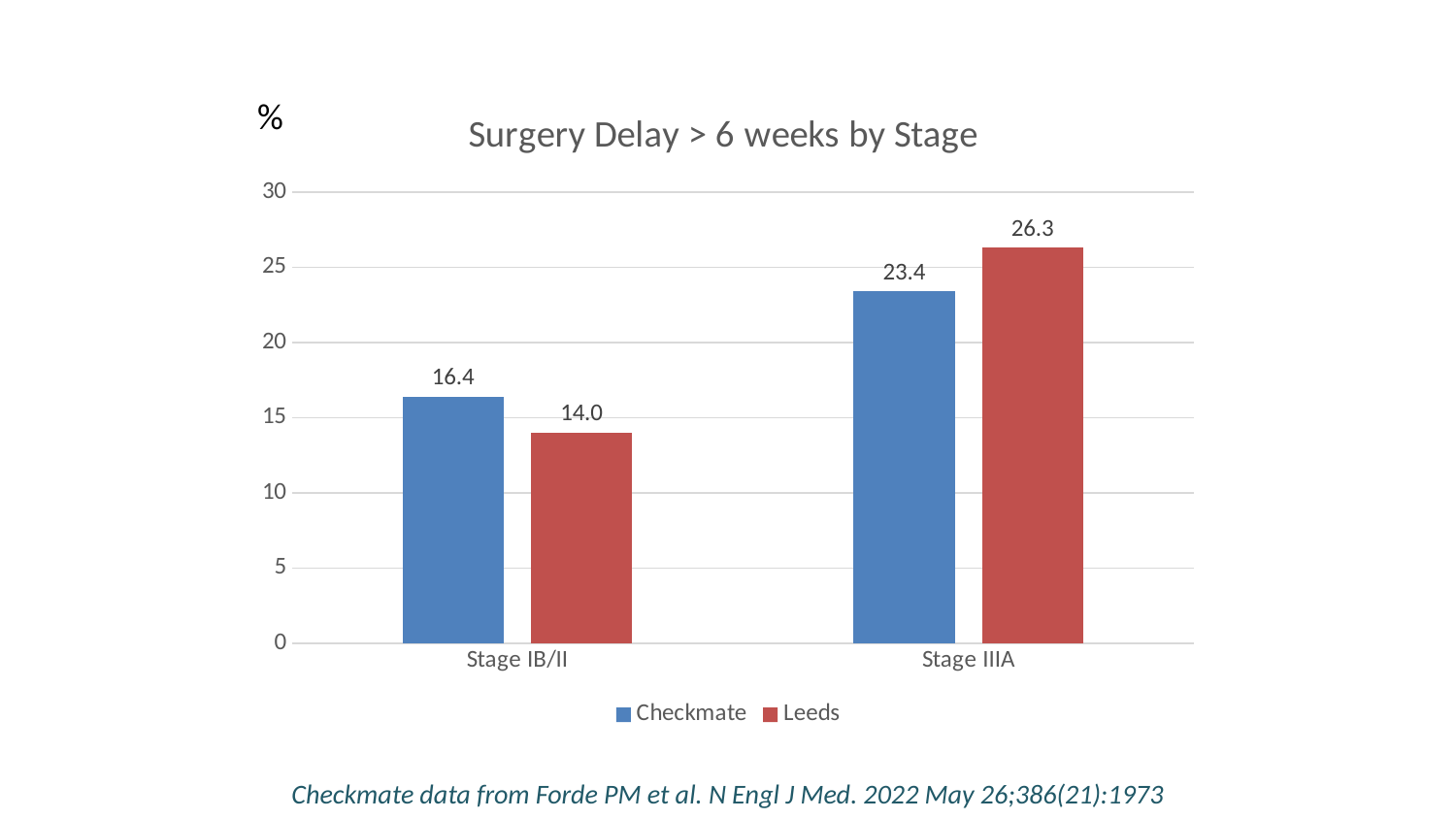
Which series has the lowest value at Stage IB/II? Leeds What is the title of the chart? Surgery Delay > 6 weeks by Stage What is the value for Leeds at Stage IB/II? 14.0 What is the value for Leeds at Stage IIIA? 26.3 How many stage categories are shown on the x axis? 2 Which is larger at Stage IB/II, Checkmate or Leeds? Checkmate What is the value for Checkmate at Stage IB/II? 16.4 Which series has the highest value at Stage IIIA? Leeds What is the value for Checkmate at Stage IIIA? 23.4 What is the difference between the Leeds and Checkmate values at Stage IIIA? 2.9 How many series does the legend list? 2 What kind of chart is shown? Bar chart